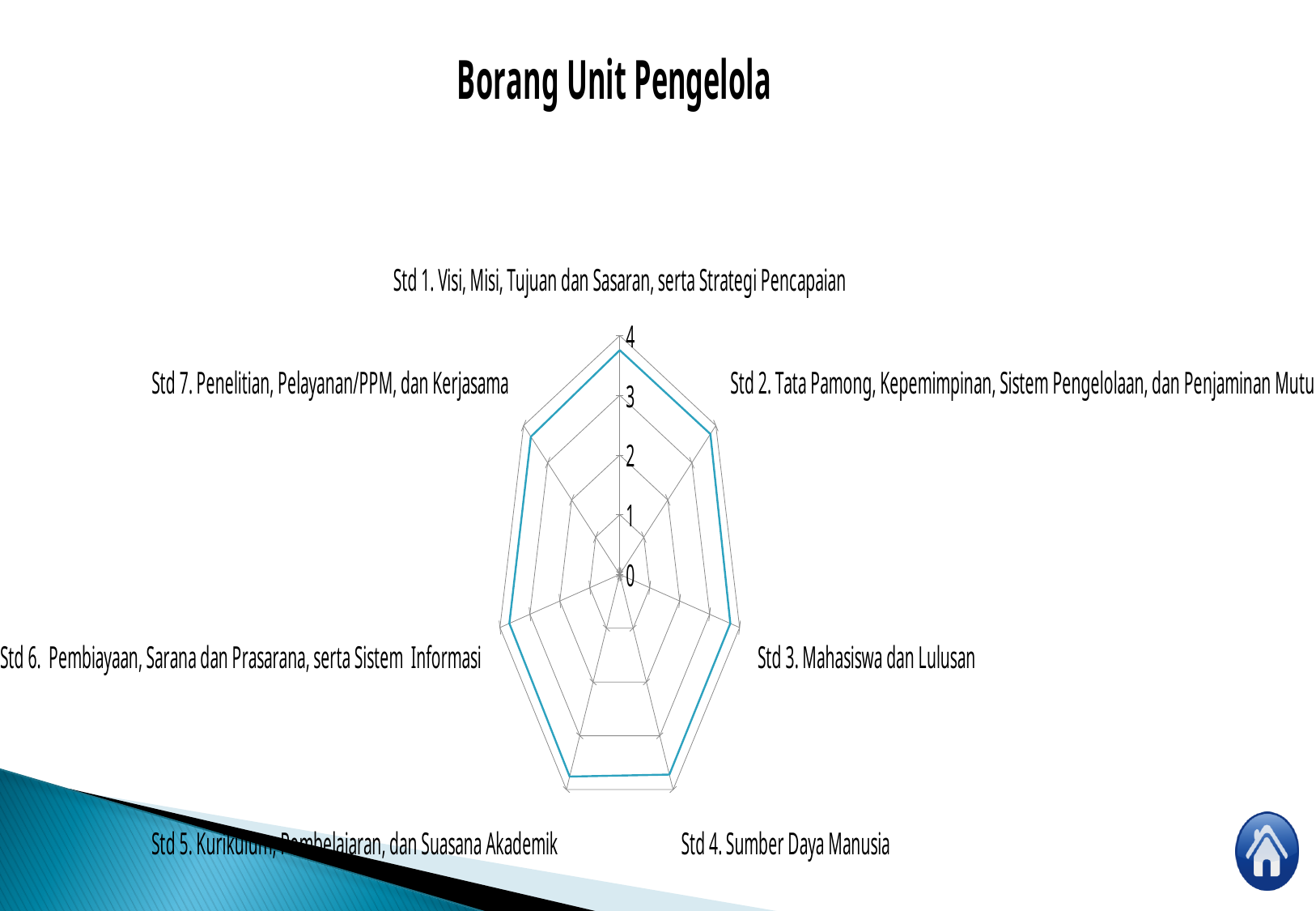
Is the value for Std 3. Mahasiswa dan Lulusan greater or less than 2? greater What is the highest tick value shown on the radar chart's axis? 4 What is the title of the chart on the slide? Borang Unit Pengelola Is the value for Std 6. Pembiayaan, Sarana dan Prasarana, serta Sistem Informasi greater or less than 2? greater Is the value for Std 7. Penelitian, Pelayanan/PPM, dan Kerjasama greater or less than 3? greater How many categories (standards) are plotted on the radar chart? 7 What kind of chart is shown on the slide? Radar chart